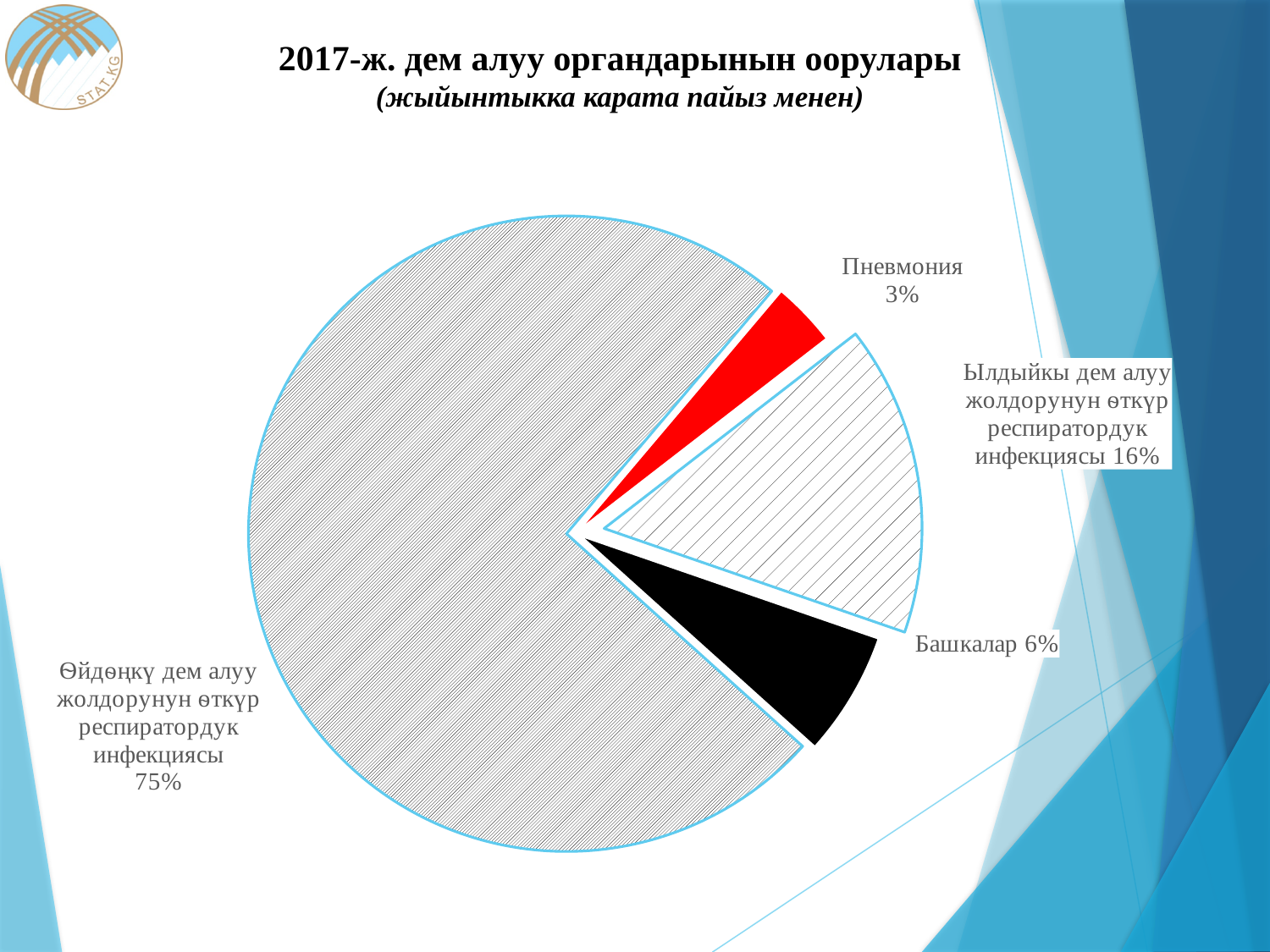
What is the difference in percentage points between Ылдыйкы дем алуу жолдорунун өткүр респиратордук инфекциясы and Башкалар? 10 How many slices does the pie chart have? 4 What share of the pie does Пневмония have? 3% What share of the pie does Ылдыйкы дем алуу жолдорунун өткүр респиратордук инфекциясы have? 16% Which category has the largest slice of the pie? Өйдөңкү дем алуу жолдорунун өткүр респиратордук инфекциясы What kind of chart is shown on the slide? Pie chart What share of the pie does Башкалар have? 6% What year is named in the chart title? 2017 Which is larger, the slice for Башкалар or the slice for Пневмония? Башкалар Which category has the smallest slice of the pie? Пневмония What share of the pie does Өйдөңкү дем алуу жолдорунун өткүр респиратордук инфекциясы have? 75% What is the difference in percentage points between the largest slice and the slice for Ылдыйкы дем алуу жолдорунун өткүр респиратордук инфекциясы? 59